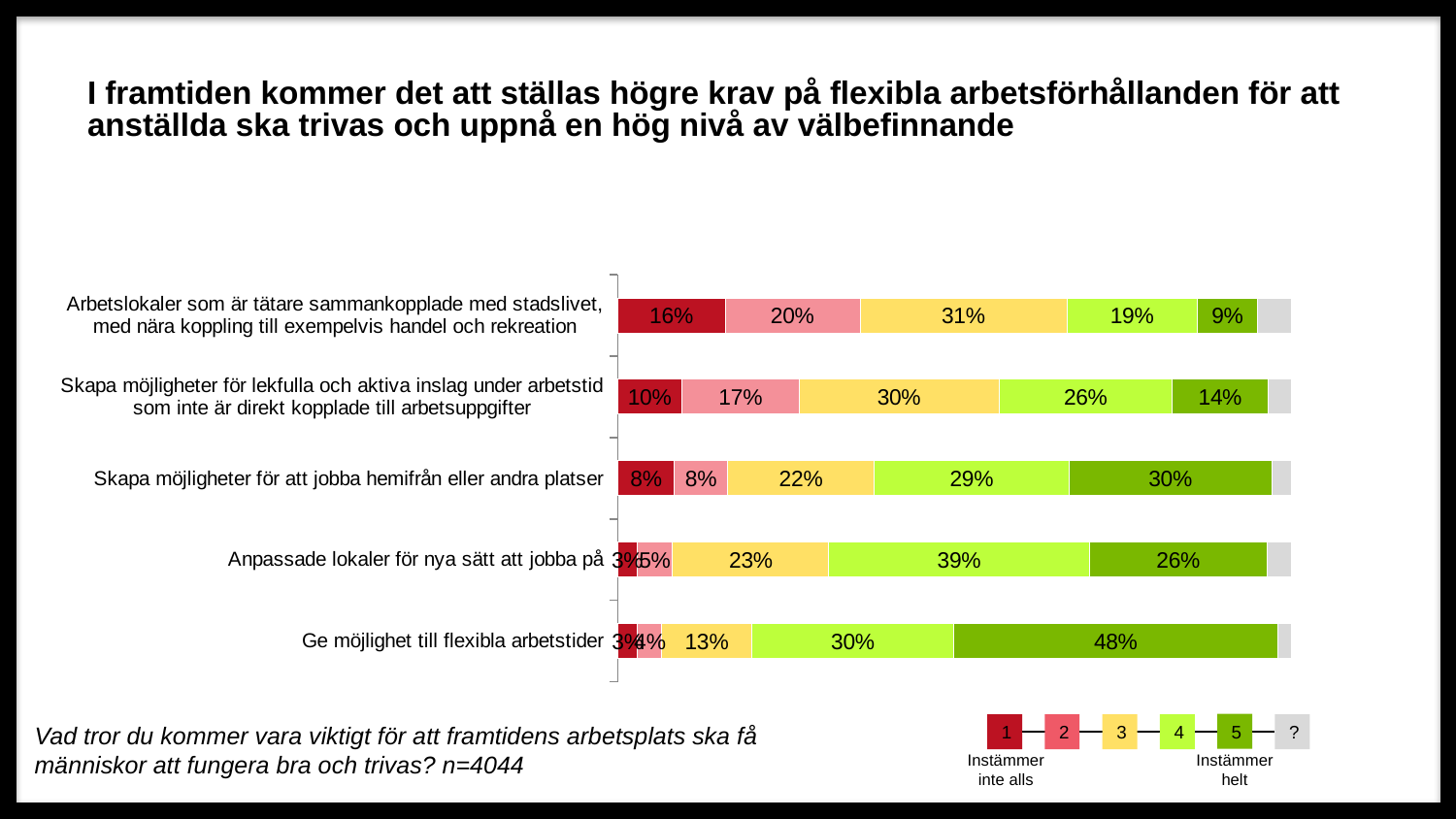
What percentage answered 3 for 'Arbetslokaler som är tätare sammankopplade med stadslivet, med nära koppling till exempelvis handel och rekreation'? 31% For 'Ge möjlighet till flexibla arbetstider', what is the difference between the share answering 5 and the share answering 4? 18 percentage points Which statement has the lowest share answering 5 (Instämmer helt)? Arbetslokaler som är tätare sammankopplade med stadslivet, med nära koppling till exempelvis handel och rekreation What kind of chart is shown on the slide? Stacked bar chart What label does the legend give to the value 1? Instämmer inte alls What percentage answered 2 for 'Skapa möjligheter för att jobba hemifrån eller andra platser'? 8% Which statement has the highest share answering 5 (Instämmer helt)? Ge möjlighet till flexibla arbetstider What percentage answered 1 (Instämmer inte alls) for 'Skapa möjligheter för lekfulla och aktiva inslag under arbetstid som inte är direkt kopplade till arbetsuppgifter'? 10% What percentage answered 5 (Instämmer helt) for 'Ge möjlighet till flexibla arbetstider'? 48% Which has a larger share answering 4: 'Anpassade lokaler för nya sätt att jobba på' or 'Skapa möjligheter för att jobba hemifrån eller andra platser'? Anpassade lokaler för nya sätt att jobba på How many statements (categories) are plotted in the chart? 5 How many entries does the legend list? 6